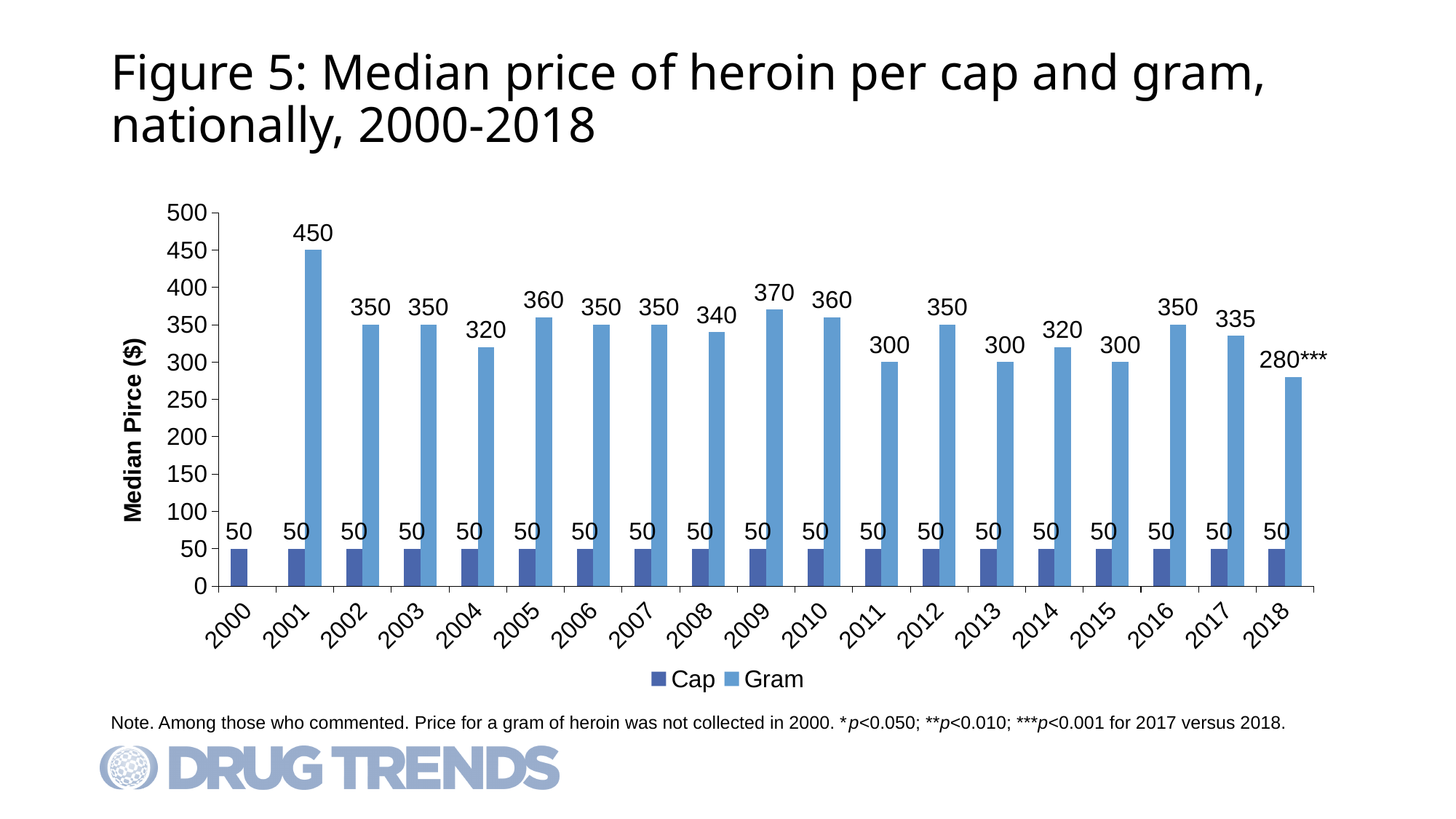
What is the difference between the median price per gram in 2017 and in 2018? 55 What is the difference between the median price per gram and per cap in 2004? 270 In which year is the median price per gram highest? 2001 What is the label of the y axis? Median Pirce ($) What is the median price per gram of heroin in 2018? 280 What kind of chart is shown on the slide? Bar chart How many years are shown on the x axis? 19 How many series does the legend list? 2 What is the median price per gram of heroin in 2001? 450 Which is larger, the median price per gram in 2009 or in 2011? 2009 What is the median price per cap of heroin in 2010? 50 In which year is the median price per gram lowest? 2018